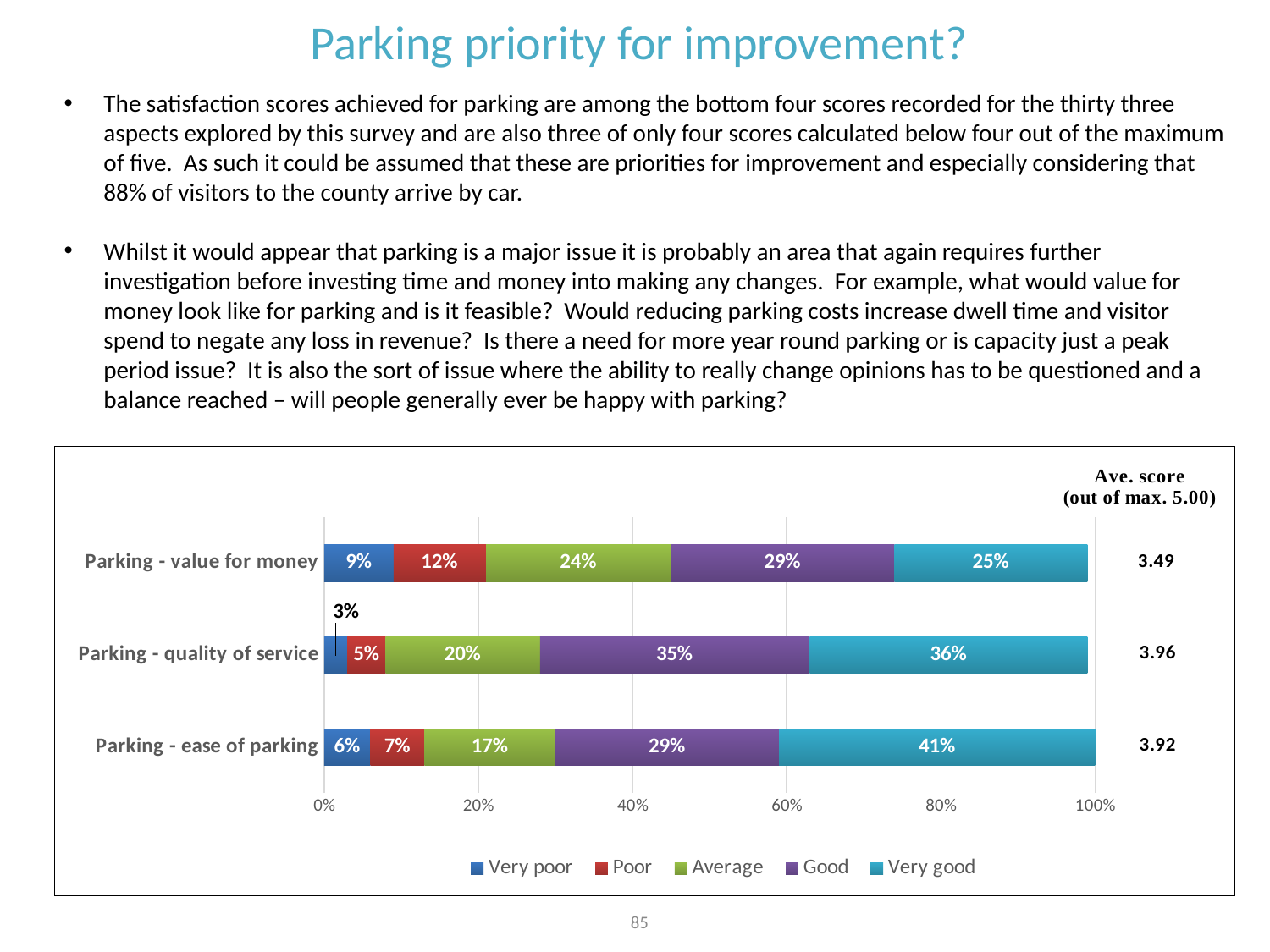
How many parking aspects (categories) are shown in the chart? 3 How many rating series does the legend list? 5 What type of chart is used on this slide? Stacked bar chart What is the Poor percentage for 'Parking - value for money'? 12% What percentage of respondents rated 'Parking - ease of parking' as Very good? 41% Which has the larger Average share: 'Parking - value for money' or 'Parking - ease of parking'? Parking - value for money How many percentage points higher is the Good share for 'Parking - quality of service' than for 'Parking - value for money'? 6 percentage points Which parking aspect has the highest Very good percentage? Parking - ease of parking What is the average score (out of max. 5.00) shown for 'Parking - quality of service'? 3.96 What is the Very poor percentage for 'Parking - quality of service'? 3% Which parking aspect has the lowest Very poor percentage? Parking - quality of service What is the total of the stacked bar for 'Parking - ease of parking'? 100%